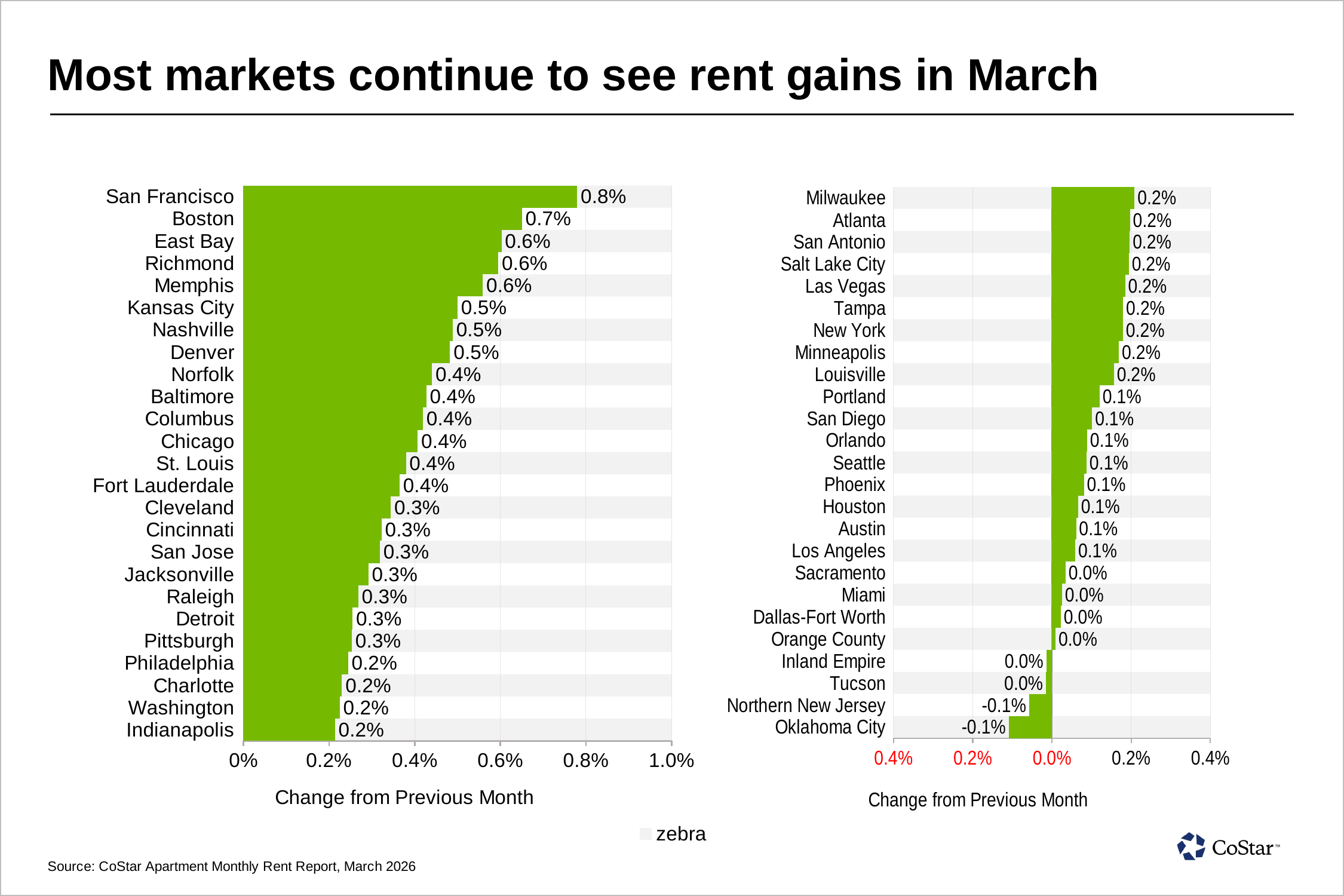
How many markets are shown in the left chart? 25 In the left chart, what is the difference between the values for San Francisco and Indianapolis? 0.6% In the left chart, is the value for Kansas City greater or less than 0.4%? greater What kind of chart is the left chart? bar chart In the left chart, which market has the highest change from previous month? San Francisco What is the x-axis title of the left chart? Change from Previous Month How many entries does the legend at the bottom of the slide list? 1 In the left chart, which is larger, the value for Boston or the value for Memphis? Boston In the right chart, what is the change from previous month for Sacramento? 0.0% In the right chart, what is the change from previous month for Oklahoma City? -0.1% How many markets are shown in the right chart? 25 In the left chart, what is the change from previous month for San Francisco? 0.8%